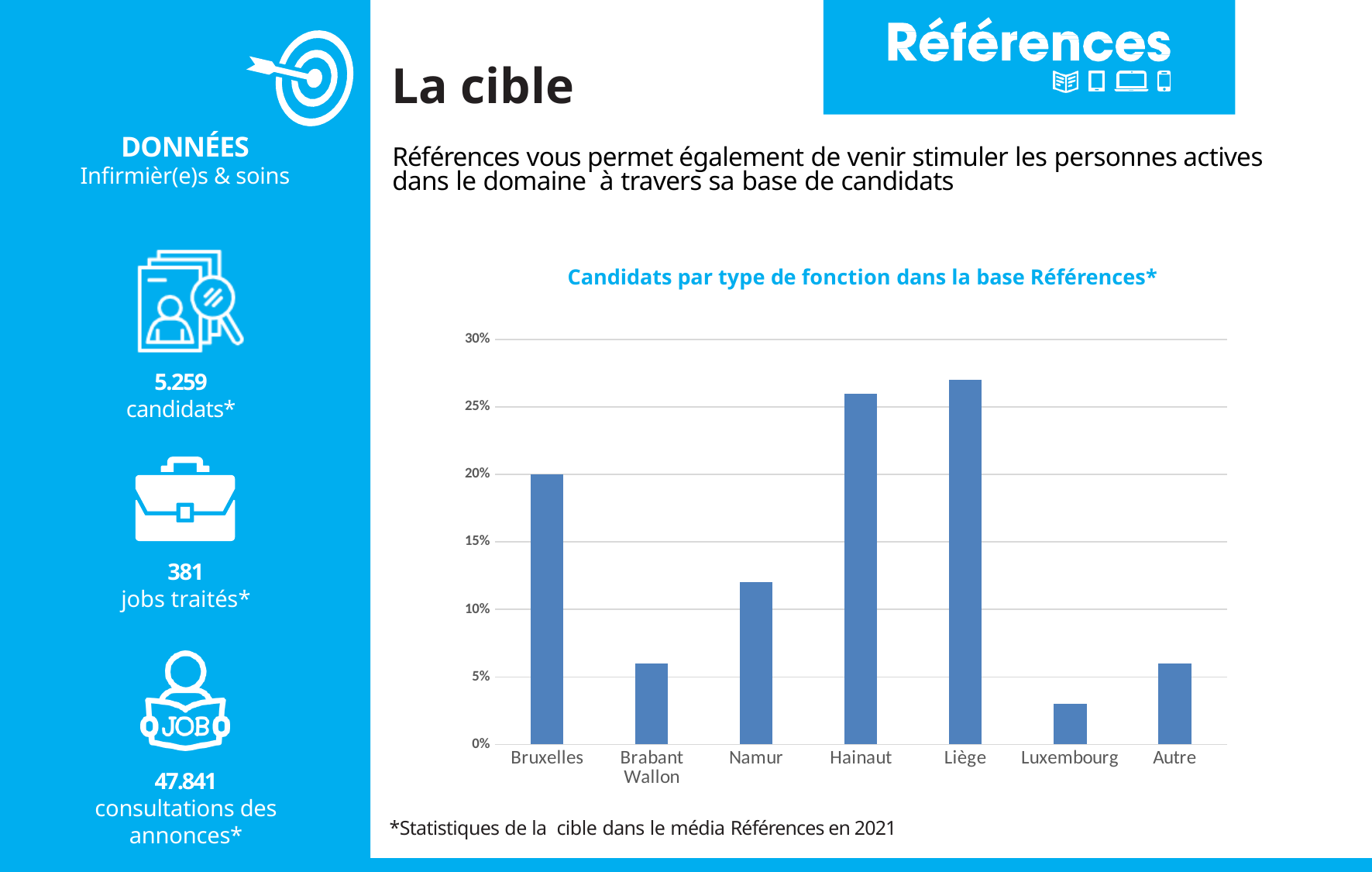
Is the value for Luxembourg greater or less than 5%? less Which is larger, the value for Hainaut or the value for Autre? Hainaut How many categories are shown on the x axis of the chart? 7 Is the value for Namur greater or less than 10%? greater Which category has the lowest value? Luxembourg What type of chart is shown on the slide? bar chart Is the value for Brabant Wallon greater or less than 10%? less What is the value for Bruxelles? 20% What is the title of the chart? Candidats par type de fonction dans la base Références* Which is larger, the value for Bruxelles or the value for Namur? Bruxelles